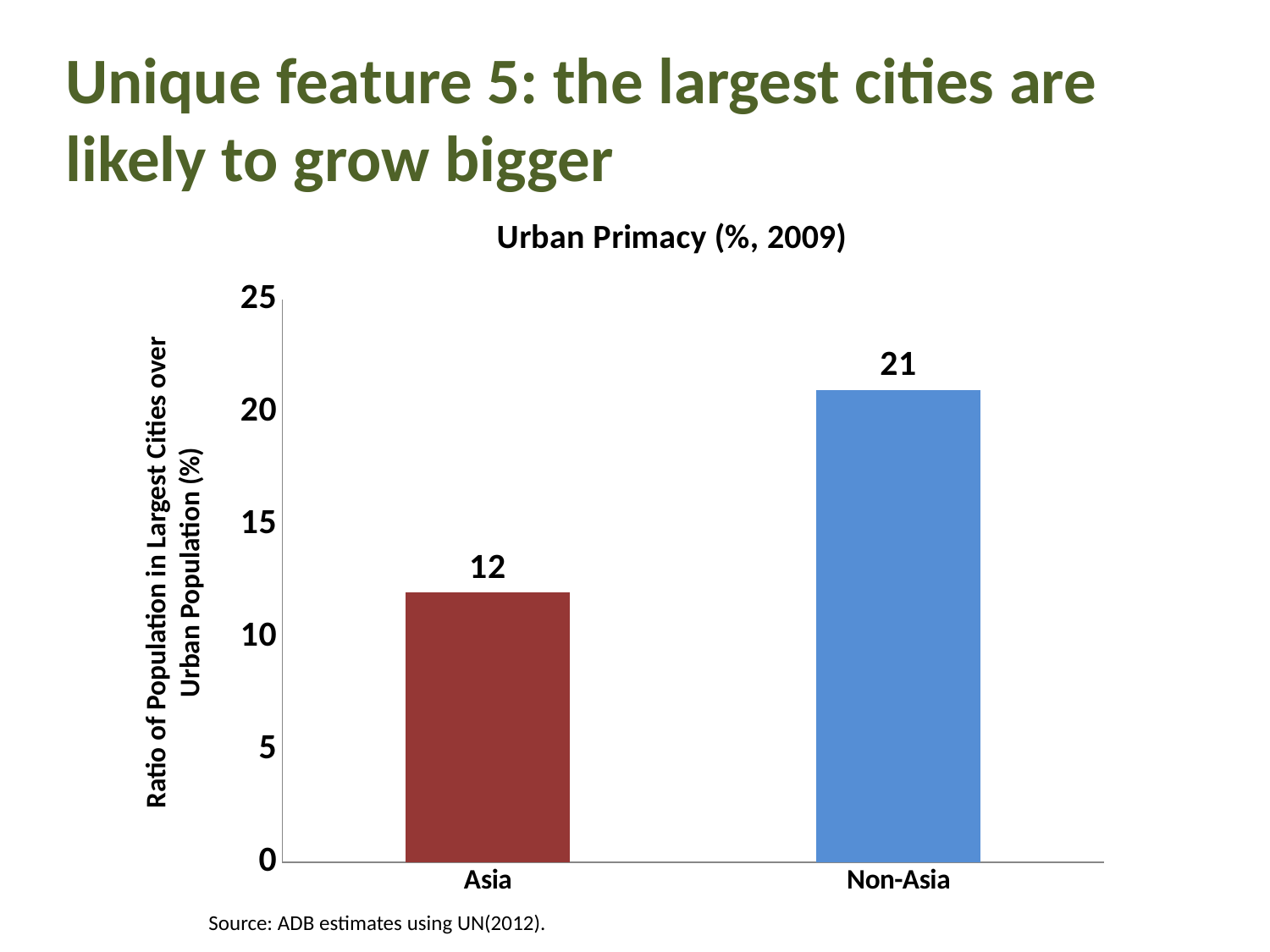
What is the urban primacy value for Asia? 12 Which category has the lowest urban primacy? Asia How many categories are shown on the x axis of the chart? 2 What colour is the bar for Asia? Red What is the title of the chart? Urban Primacy (%, 2009) Which has a larger urban primacy value, Asia or Non-Asia? Non-Asia What is the urban primacy value for Non-Asia? 21 What is the difference between the urban primacy values for Non-Asia and Asia? 9 Is the value for Asia greater or less than 15? less What kind of chart is shown on the slide? Bar chart Which category has the highest urban primacy? Non-Asia Is the value for Non-Asia greater or less than 20? greater